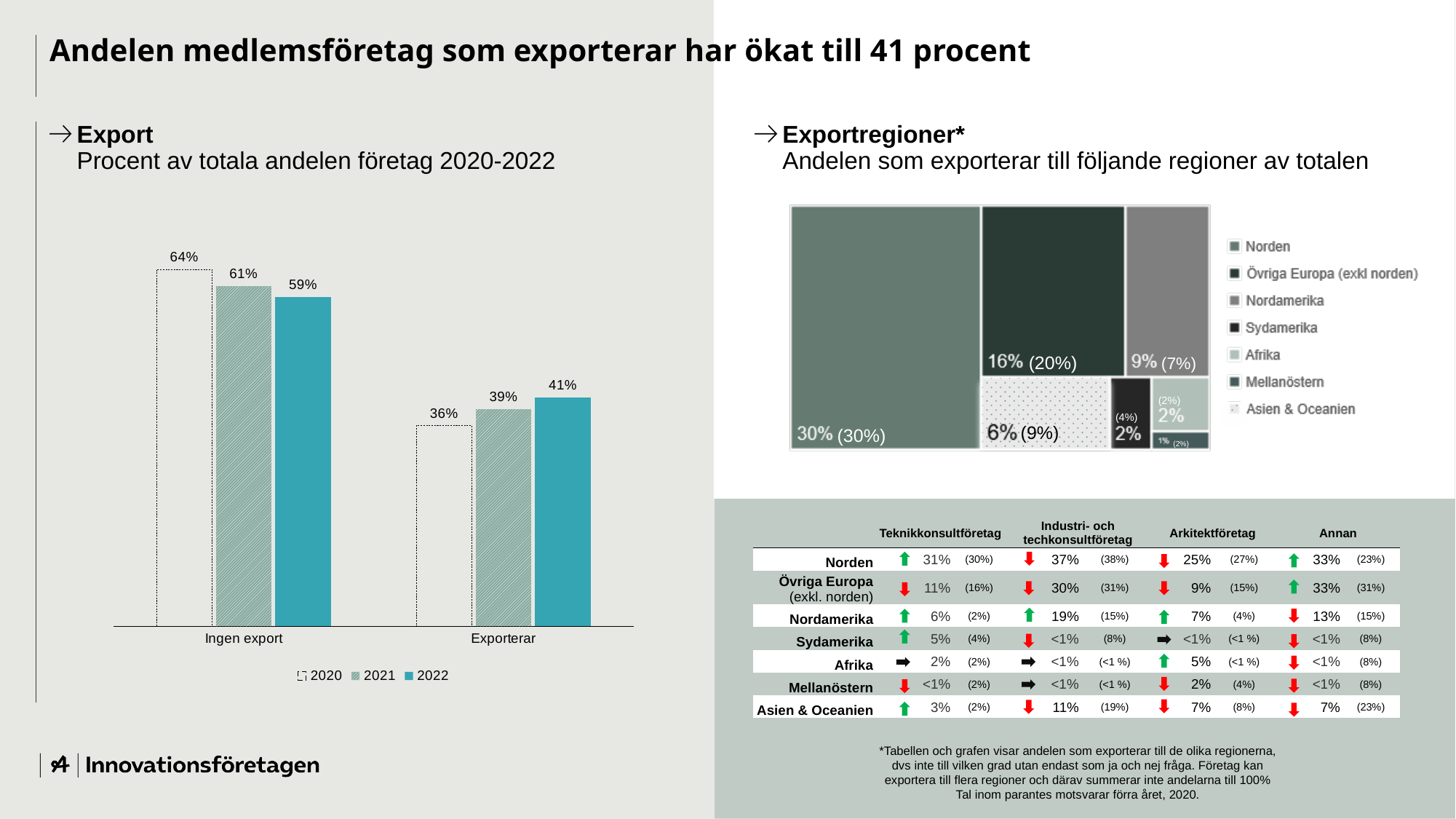
In the Export bar chart, what is the value for Ingen export in 2020? 64% In the Export bar chart, how many series does the legend list? 3 In the Exportregioner chart, which region has the largest share? Norden In the Export bar chart, do the values for Ingen export rise or fall from 2020 to 2022? fall In the Export bar chart, what is the value for Exporterar in 2022? 41% In the Export bar chart, how many categories are shown on the x axis? 2 In the Export bar chart, what is the value for Exporterar in 2021? 39% In the Exportregioner chart, what share of companies export to Norden? 30% In the Export bar chart, which is larger for 2022: Ingen export or Exporterar? Ingen export In the Exportregioner chart, what share of companies export to Övriga Europa (exkl norden)? 16% In the Export bar chart, what is the difference between the 2020 and 2022 values for Exporterar? 5% What kind of chart is the Export chart on the left? bar chart